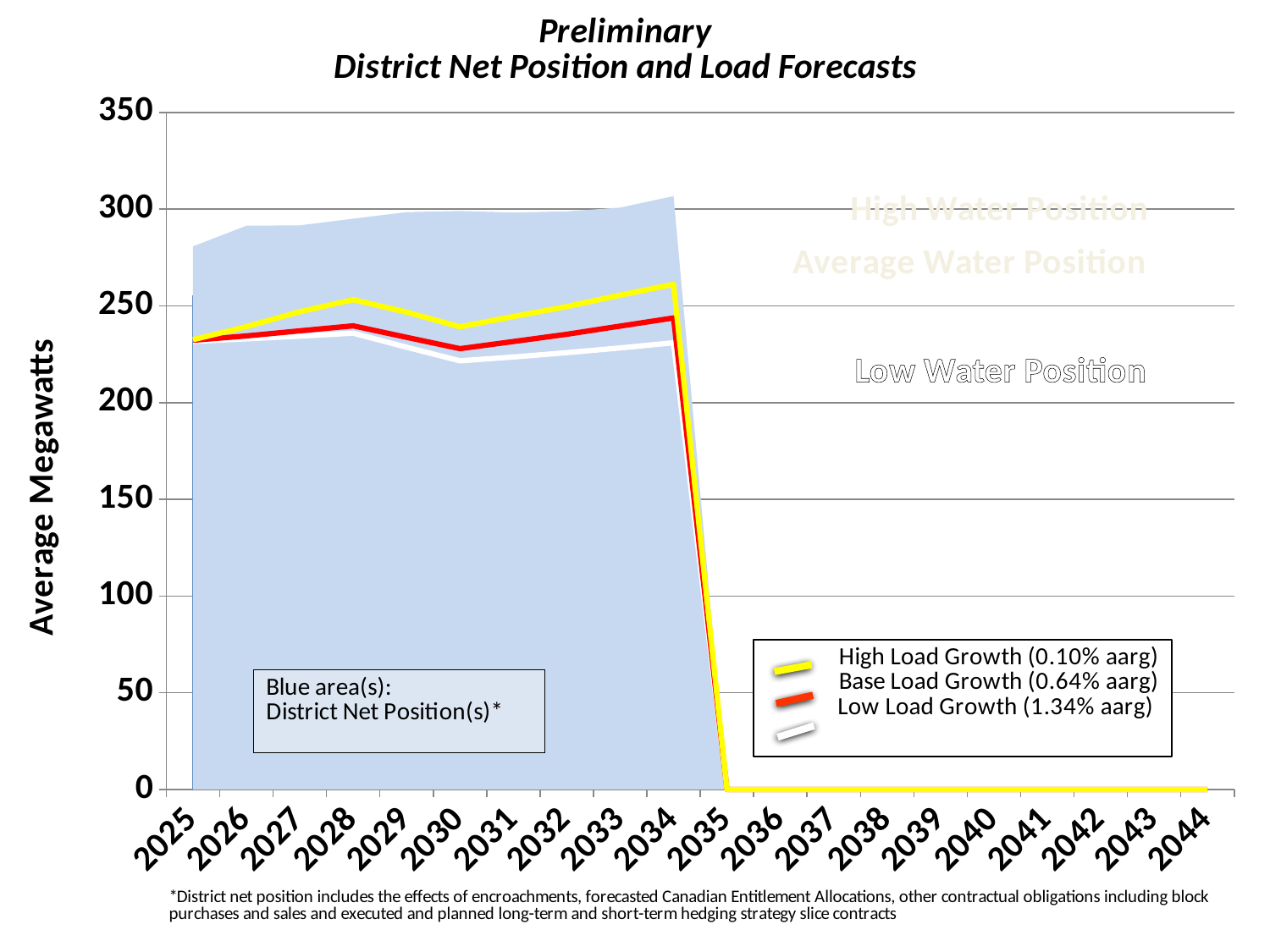
Is the Low Load Growth value for 2030 greater or less than 200? greater Which is larger in 2034, the High Load Growth value or the Low Load Growth value? High Load Growth What is the label on the y axis? Average Megawatts Is the High Load Growth value for 2034 greater or less than 250? greater Do the load growth lines generally rise or fall from 2025 to 2034? rise What annual growth rate does the legend give for Base Load Growth? 0.64% aarg How many years are labelled along the x axis? 20 In which year does the High Load Growth line reach its highest value? 2034 How many series does the legend list? 3 What kind of chart is shown on the slide? combination area and line chart Is the Base Load Growth value for 2030 greater or less than 250? less